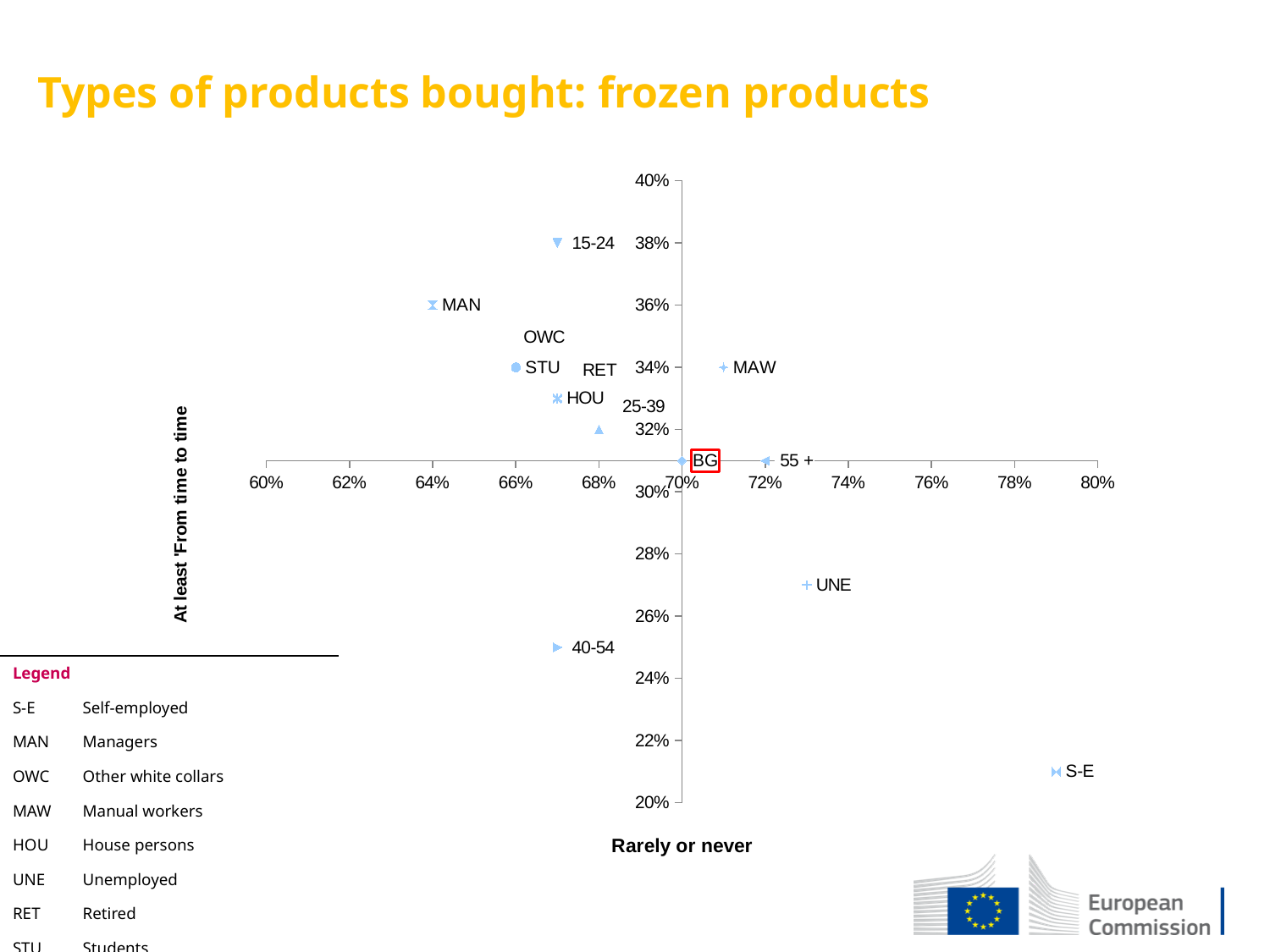
Is the horizontal-axis value for S-E greater or less than 78%? greater What kind of chart is shown on the slide? Scatter chart Which group has the highest value on the vertical axis (At least 'From time to time')? 15-24 Which group has the lowest value on the horizontal axis (Rarely or never)? MAN Which group has the highest value on the horizontal axis (Rarely or never)? S-E Which group has the lowest value on the vertical axis (At least 'From time to time')? S-E Which has the higher horizontal-axis value, UNE or MAW? UNE Is the vertical-axis value for 15-24 greater or less than 36%? greater What is the label of the horizontal axis? Rarely or never Is the vertical-axis value for S-E greater or less than 22%? less Which has the higher vertical-axis value, 15-24 or 40-54? 15-24